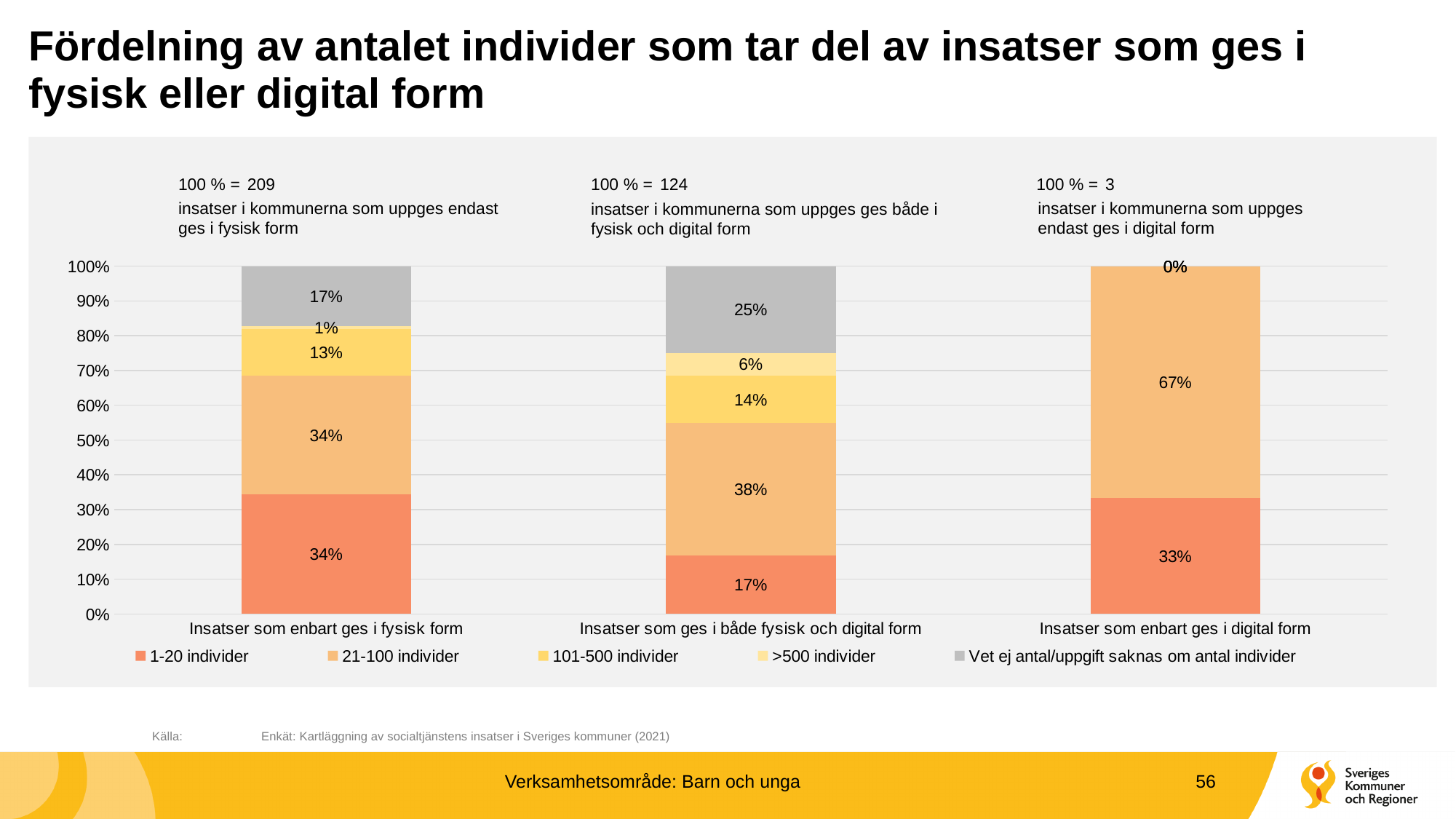
How many categories are shown on the x axis of the chart? 3 What is the value for '21-100 individer' in the category 'Insatser som ges i både fysisk och digital form'? 38% How many series does the legend list? 5 What is the value for '1-20 individer' in the category 'Insatser som enbart ges i fysisk form'? 34% What is the value for '21-100 individer' in the category 'Insatser som enbart ges i digital form'? 67% What is the value for 'Vet ej antal/uppgift saknas om antal individer' in the category 'Insatser som ges i både fysisk och digital form'? 25% What is the value for '>500 individer' in the category 'Insatser som enbart ges i fysisk form'? 1% What kind of chart is shown on the slide? Stacked bar chart According to the note above the first bar, how many insatser does 100 % correspond to for 'Insatser som enbart ges i fysisk form'? 209 Which is larger: the '101-500 individer' value for 'Insatser som enbart ges i fysisk form' or for 'Insatser som ges i både fysisk och digital form'? Insatser som ges i både fysisk och digital form Which category has the highest value for '1-20 individer'? Insatser som enbart ges i fysisk form What is the difference between the '21-100 individer' values for 'Insatser som enbart ges i digital form' and 'Insatser som enbart ges i fysisk form'? 33 percentage points